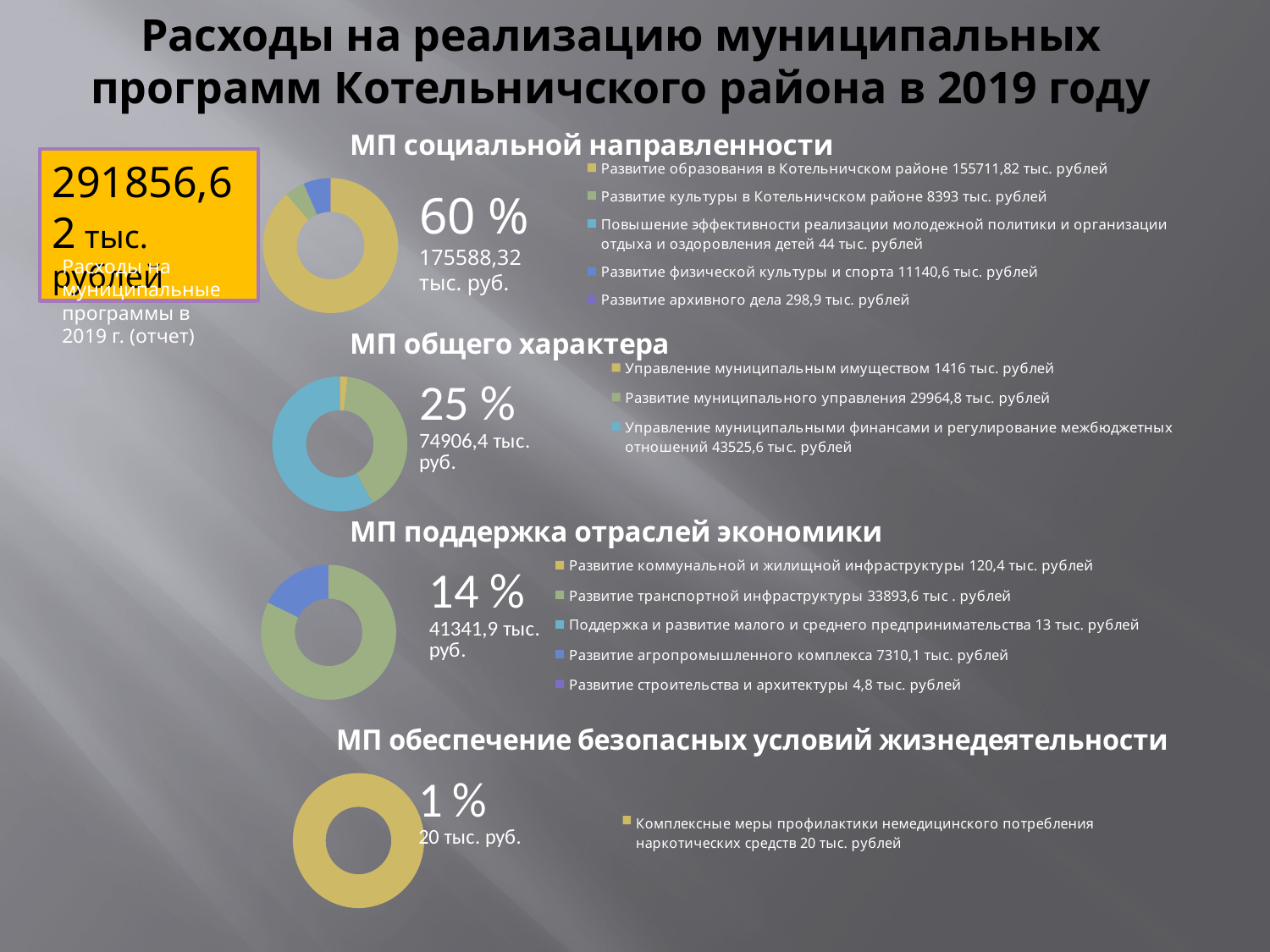
In the chart 'МП социальной направленности', what is the value for 'Развитие культуры в Котельничском районе'? 8393 тыс. рублей What kind of chart is used for 'МП обеспечение безопасных условий жизнедеятельности'? Doughnut (pie) chart How many categories does the legend of the chart 'МП социальной направленности' list? 5 In the chart 'МП общего характера', what is the difference between 'Управление муниципальными финансами и регулирование межбюджетных отношений' and 'Развитие муниципального управления'? 13560,8 тыс. рублей In the chart 'МП поддержка отраслей экономики', which is larger: 'Развитие агропромышленного комплекса' or 'Развитие коммунальной и жилищной инфраструктуры'? Развитие агропромышленного комплекса In the chart 'МП поддержка отраслей экономики', what is the value for 'Развитие строительства и архитектуры'? 4,8 тыс. рублей How many categories does the legend of the chart 'МП обеспечение безопасных условий жизнедеятельности' list? 1 In the chart 'МП социальной направленности', which category has the smallest value? Повышение эффективности реализации молодежной политики и организации отдыха и оздоровления детей In the chart 'МП общего характера', which category has the largest value? Управление муниципальными финансами и регулирование межбюджетных отношений What percentage is shown next to the chart 'МП поддержка отраслей экономики'? 14 % In the chart 'МП общего характера', what is the value for 'Развитие муниципального управления'? 29964,8 тыс. рублей In the chart 'МП социальной направленности', which category has the largest value? Развитие образования в Котельничском районе